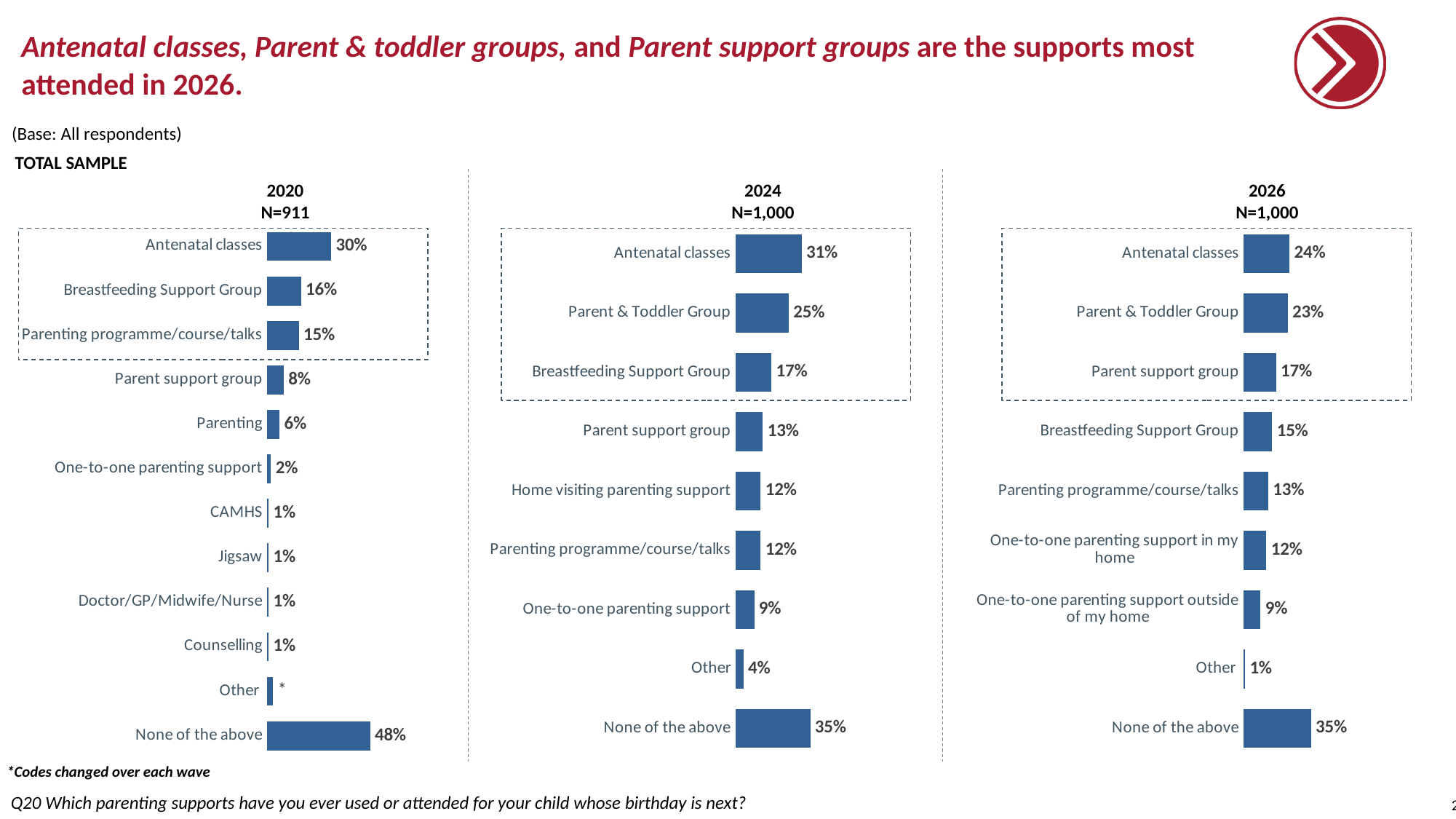
In the 2026 chart, which category has the highest value? None of the above What is the sample size (N) shown for the 2020 chart? N=911 In the 2020 chart, what is the difference between None of the above and Antenatal classes? 18 percentage points In the 2020 chart, what percentage attended Antenatal classes? 30% In the 2024 chart, which category has the lowest value? Other In the 2024 chart, what is the difference between Antenatal classes and Parent support group? 18 percentage points In the 2024 chart, what percentage attended a Parent & Toddler Group? 25% How many categories are shown in the 2024 chart? 9 What kind of chart is used for the 2026 data? Bar chart In the 2026 chart, which is larger: Antenatal classes or Parent & Toddler Group? Antenatal classes How many categories are shown in the 2020 chart? 12 In the 2026 chart, what percentage attended a Breastfeeding Support Group? 15%